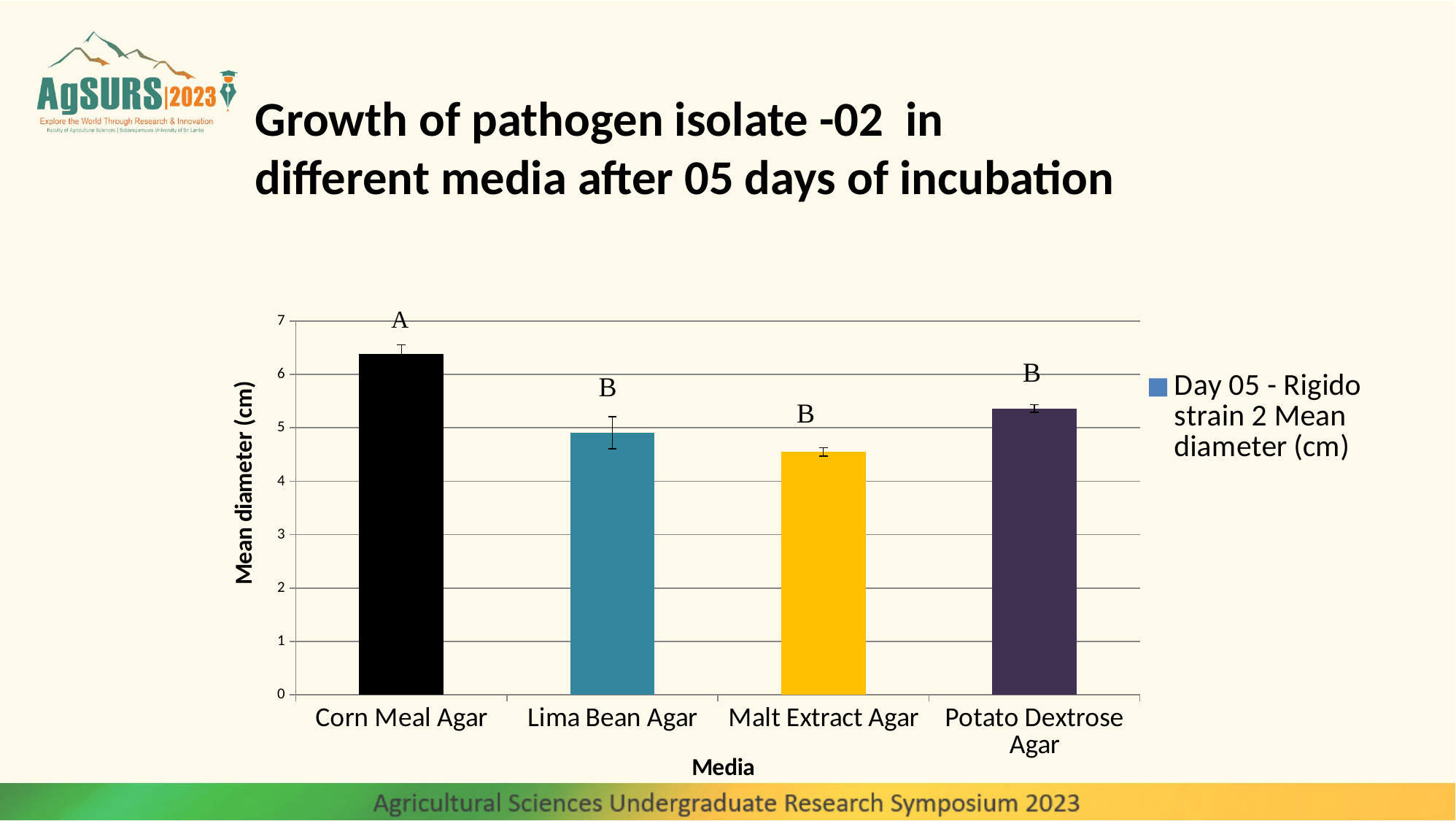
Which medium has the highest mean diameter? Corn Meal Agar What kind of chart is shown on the slide? Bar chart Is the mean diameter for Corn Meal Agar greater or less than 6? greater How many series does the legend list? 1 What letter is printed above the Corn Meal Agar bar? A Is the mean diameter for Potato Dextrose Agar greater or less than 5? greater Which has a larger mean diameter, Lima Bean Agar or Malt Extract Agar? Lima Bean Agar Is the mean diameter for Malt Extract Agar greater or less than 5? less How many media categories are plotted on the x axis? 4 What is the label of the y axis? Mean diameter (cm) Which medium has the lowest mean diameter? Malt Extract Agar Which has a larger mean diameter, Potato Dextrose Agar or Lima Bean Agar? Potato Dextrose Agar